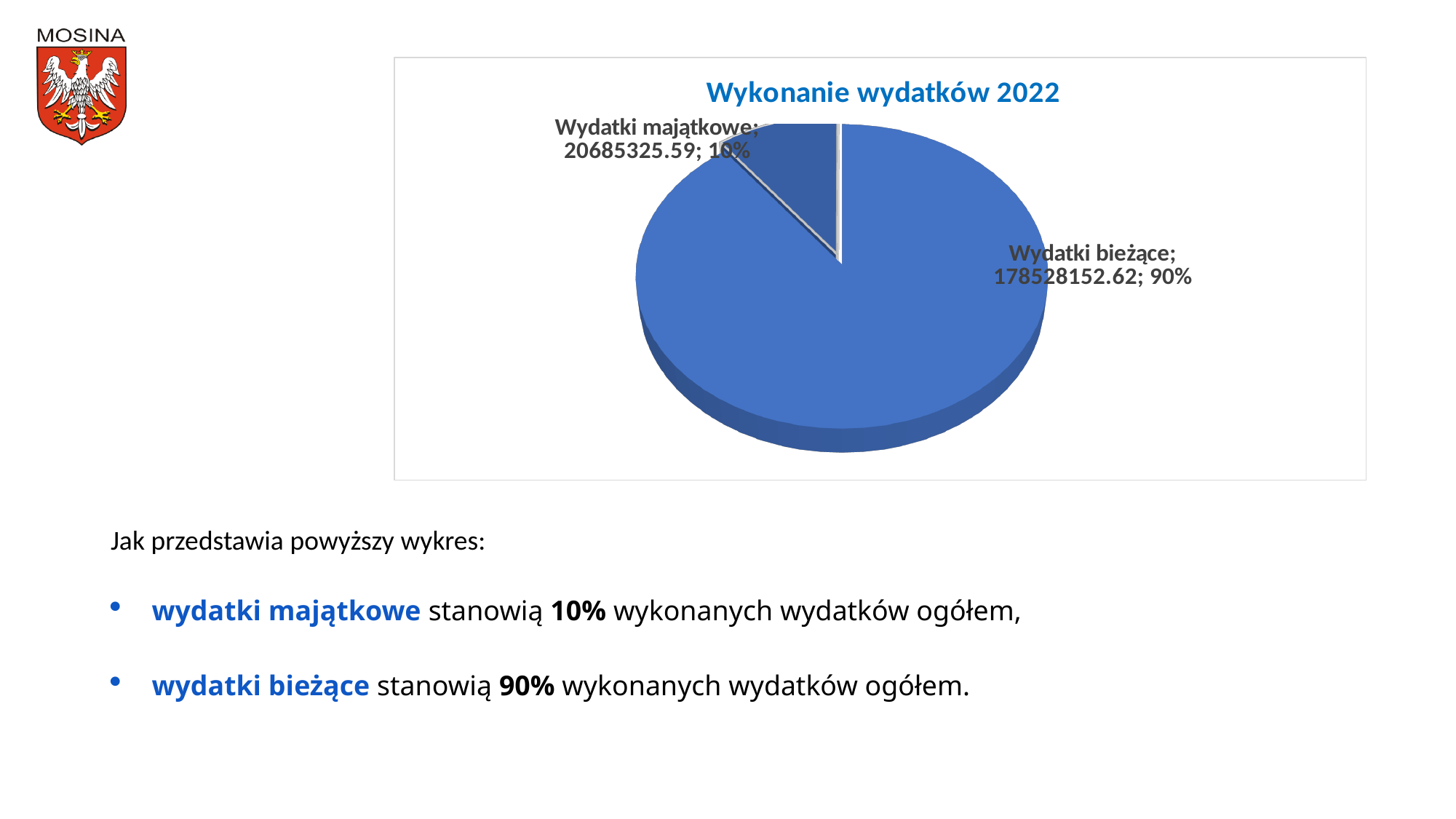
Which category has the smallest slice? Wydatki majątkowe What is the value for Wydatki bieżące? 178528152.62 What kind of chart is shown on the slide? Pie chart What share of the pie does Wydatki majątkowe represent? 10% What is the title of the chart? Wykonanie wydatków 2022 What is the total of the two values shown in the pie chart? 199213478.21 Which category has the largest slice? Wydatki bieżące What is the value for Wydatki majątkowe? 20685325.59 What share of the pie does Wydatki bieżące represent? 90% Which is larger, Wydatki bieżące or Wydatki majątkowe? Wydatki bieżące What is the difference between the values for Wydatki bieżące and Wydatki majątkowe? 157842827.03 How many slices does the pie chart have? 2